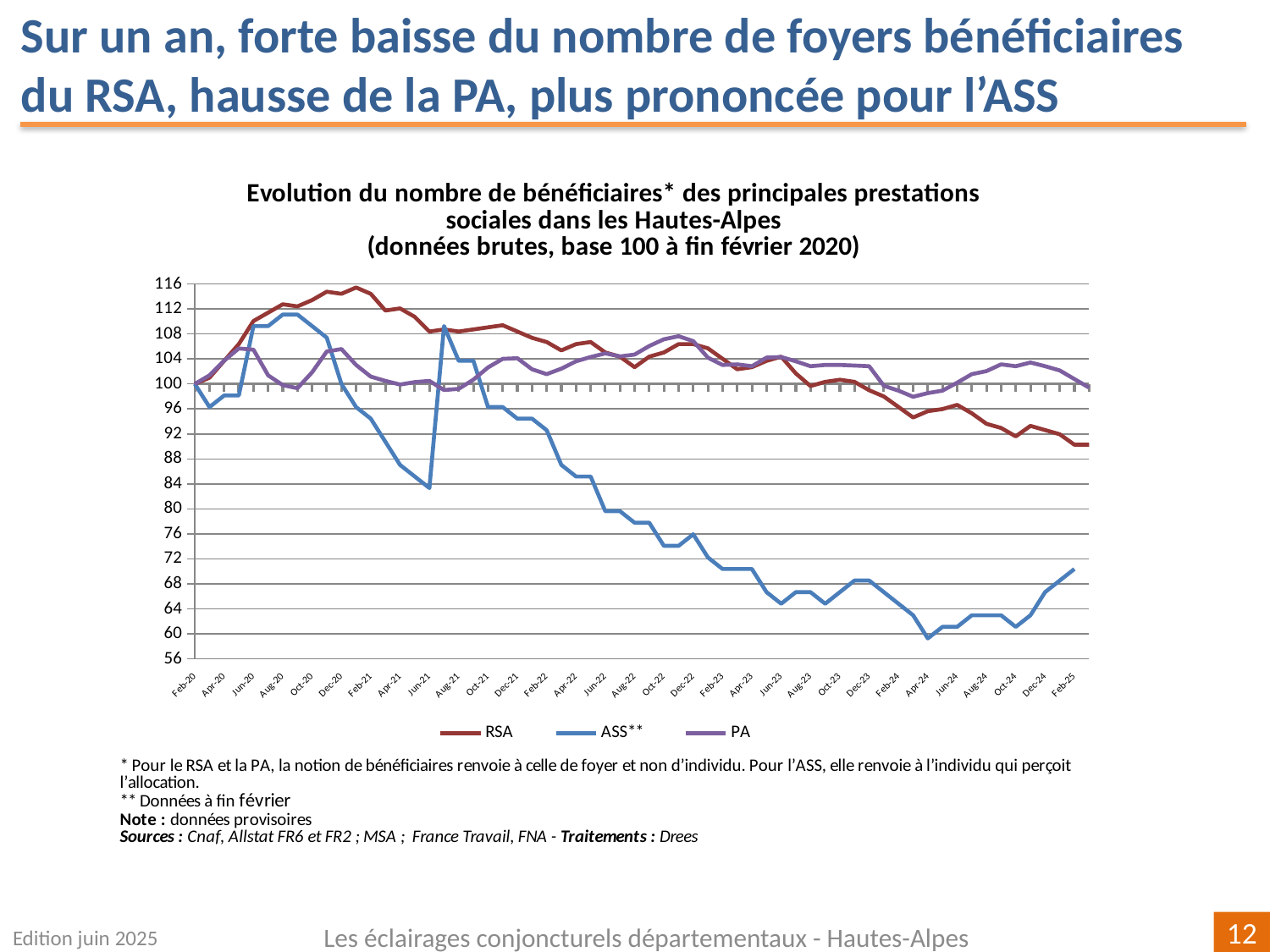
What are the three series named in the legend? RSA, ASS**, PA Does the RSA series rise or fall between Feb-23 and Feb-25? fall What kind of chart is shown on the slide? line chart Is the value for RSA at Feb-21 greater or less than 112? greater Is the value for ASS** at Jun-21 greater or less than 88? less At Feb-25, which is larger, the value for RSA or the value for PA? PA Which series is drawn in blue? ASS** Does the ASS** series rise or fall between Aug-21 and Apr-24? fall How many series does the legend list? 3 Is the value for ASS** at Feb-25 greater or less than 64? greater Which series has the lowest value at Feb-25? ASS**